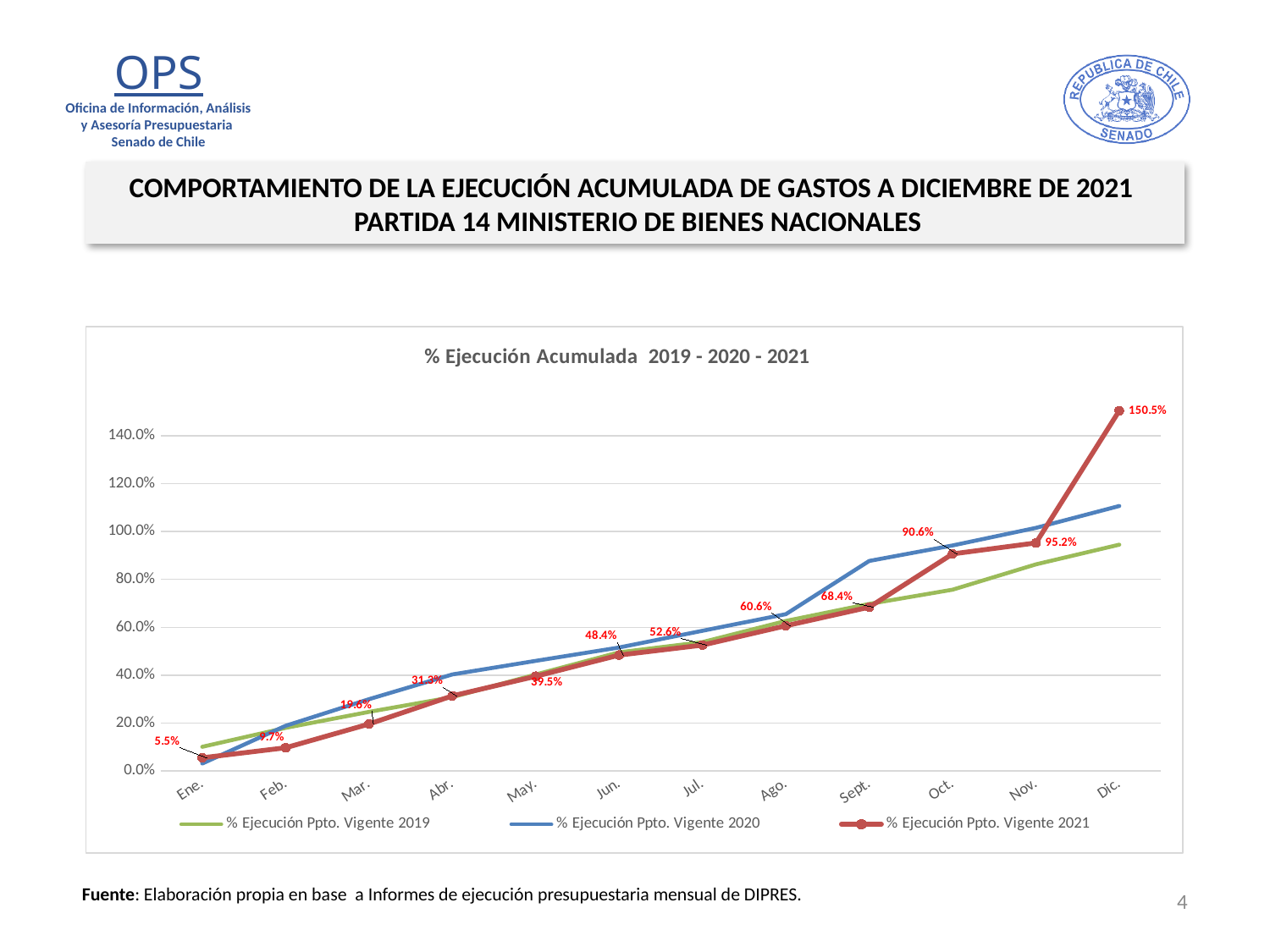
What is the value of % Ejecución Ppto. Vigente 2021 for Oct.? 90.6% In which month does the % Ejecución Ppto. Vigente 2021 series reach its highest value? Dic. What is the difference between the Dic. and Nov. values of % Ejecución Ppto. Vigente 2021? 55.3% How many months are plotted along the x axis? 12 Do the values of % Ejecución Ppto. Vigente 2021 rise or fall from Ene. to Dic.? Rise What kind of chart is shown on the slide? Line chart Is the Dic. value of % Ejecución Ppto. Vigente 2020 greater or less than 100.0%? greater In which month does the % Ejecución Ppto. Vigente 2021 series have its lowest value? Ene. What is the value of % Ejecución Ppto. Vigente 2021 for Sept.? 68.4% What is the value of % Ejecución Ppto. Vigente 2021 for Dic.? 150.5% Which series has the larger value in Dic., % Ejecución Ppto. Vigente 2021 or % Ejecución Ppto. Vigente 2020? % Ejecución Ppto. Vigente 2021 How many series does the chart legend list? 3